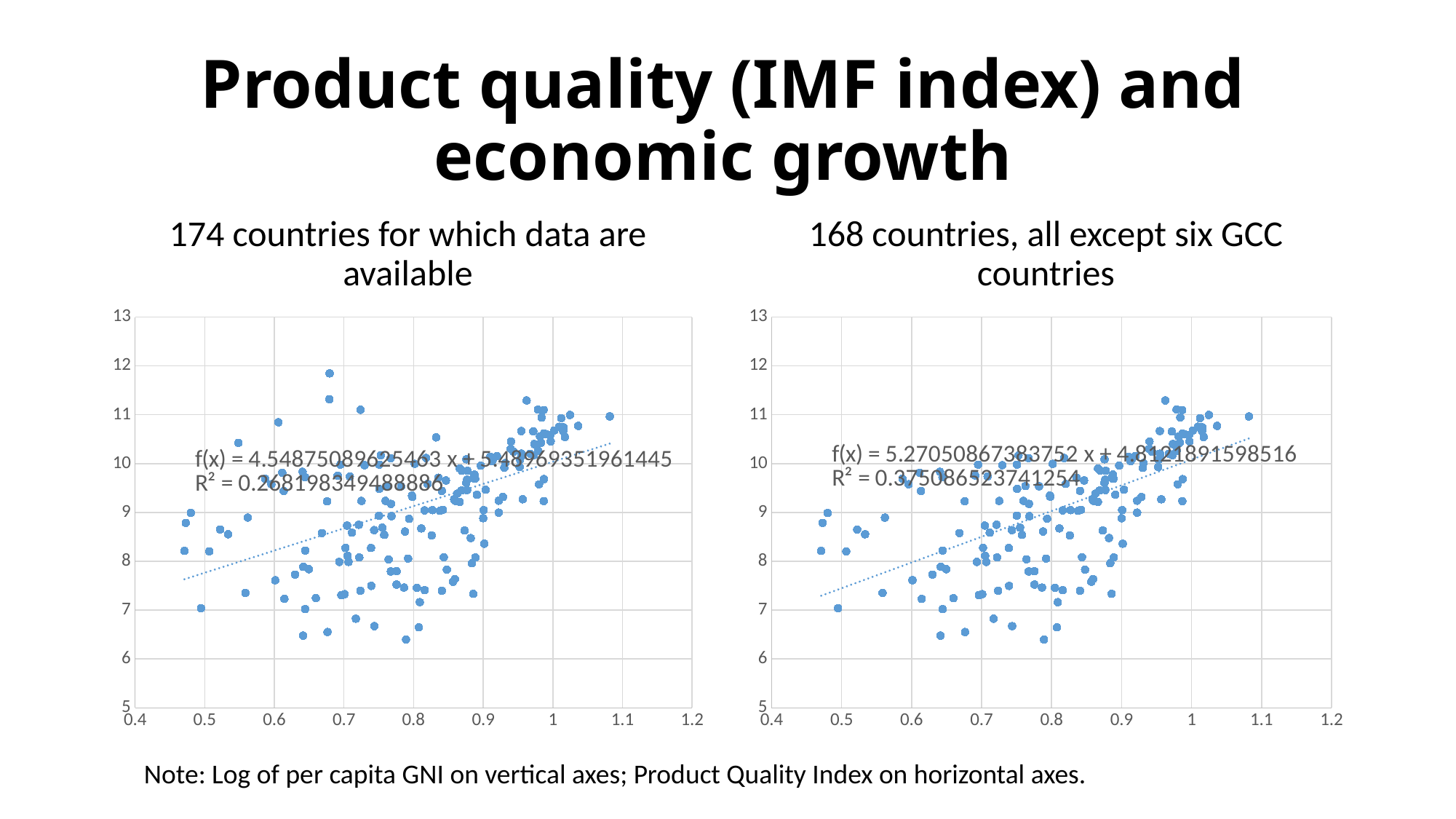
According to the note, what variable is plotted on the vertical axes of both charts? Log of per capita GNI On the left chart (174 countries), what is the slope (coefficient of x) in the printed trendline equation? 4.54875089625463 On the right chart (168 countries), does the trendline rise or fall as the Product Quality Index increases along the x axis? Rise On the left chart (174 countries), what R² value is printed for the trendline? 0.268198349488886 On the right chart (168 countries), what is the slope (coefficient of x) in the printed trendline equation? 5.27050867383752 On the left chart (174 countries), is the highest plotted point greater or less than 11 on the vertical axis? greater On the right chart (168 countries), what R² value is printed for the trendline? 0.375086523741254 What kind of chart is the left chart, titled '174 countries for which data are available'? Scatter chart Which chart shows the higher R² value, the left chart (174 countries) or the right chart (168 countries)? The right chart (168 countries) According to the note, what variable is plotted on the horizontal axes of both charts? Product Quality Index How many countries are plotted in the right chart, according to its title? 168 What kind of chart is the right chart, titled '168 countries, all except six GCC countries'? Scatter chart